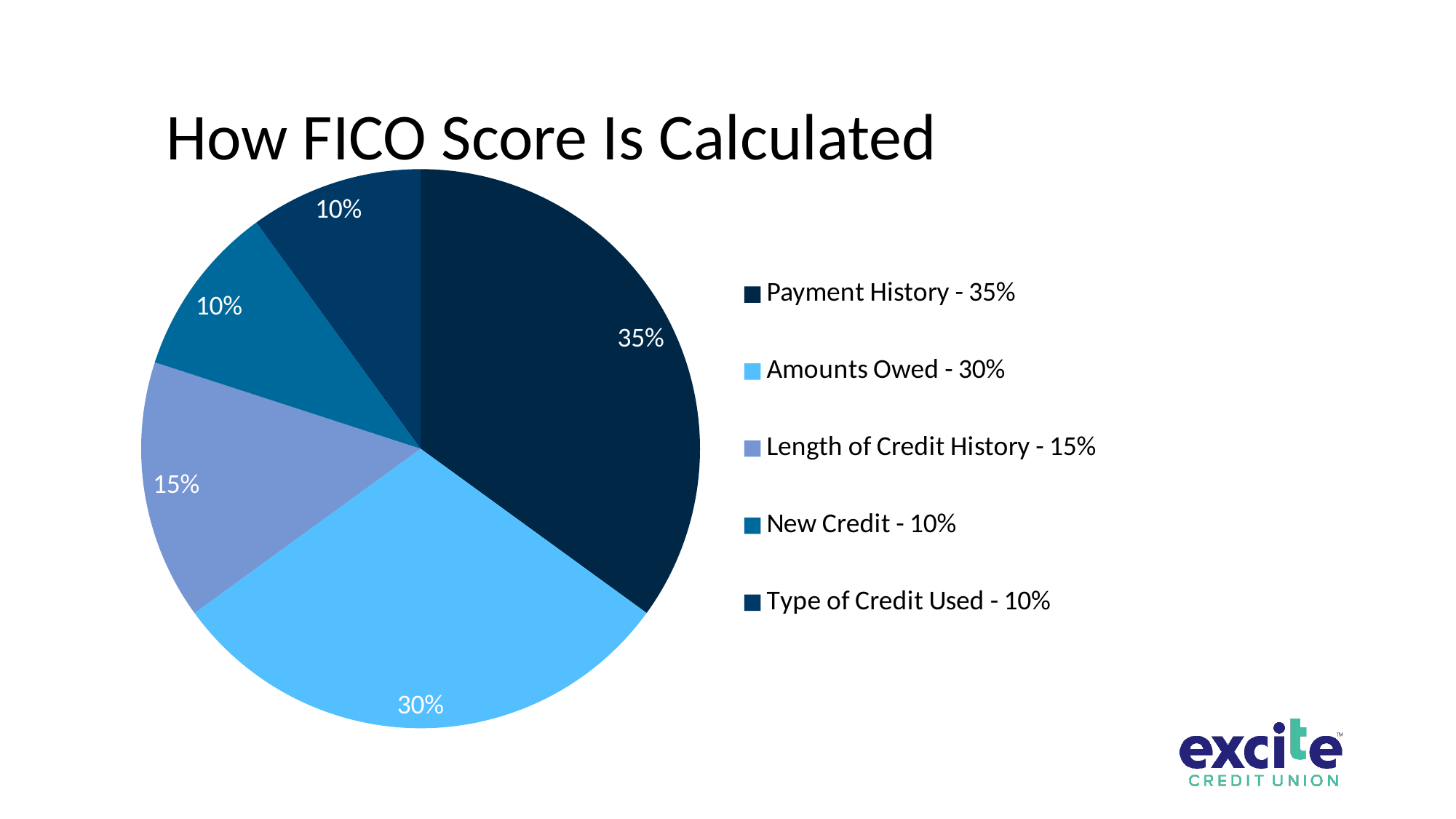
What share of the FICO score does Payment History account for? 35% What share of the FICO score does New Credit account for? 10% What kind of chart is shown on the slide? pie chart Which category has the largest slice of the pie? Payment History What share of the FICO score does Amounts Owed account for? 30% What is the difference between the Payment History share and the Amounts Owed share? 5% How many categories does the legend list? 5 Which two categories each account for 10% of the FICO score? New Credit and Type of Credit Used What is the title of the chart? How FICO Score Is Calculated Which is larger, the share for Amounts Owed or the share for Length of Credit History? Amounts Owed What is the combined share of New Credit and Type of Credit Used? 20% What share of the FICO score does Length of Credit History account for? 15%